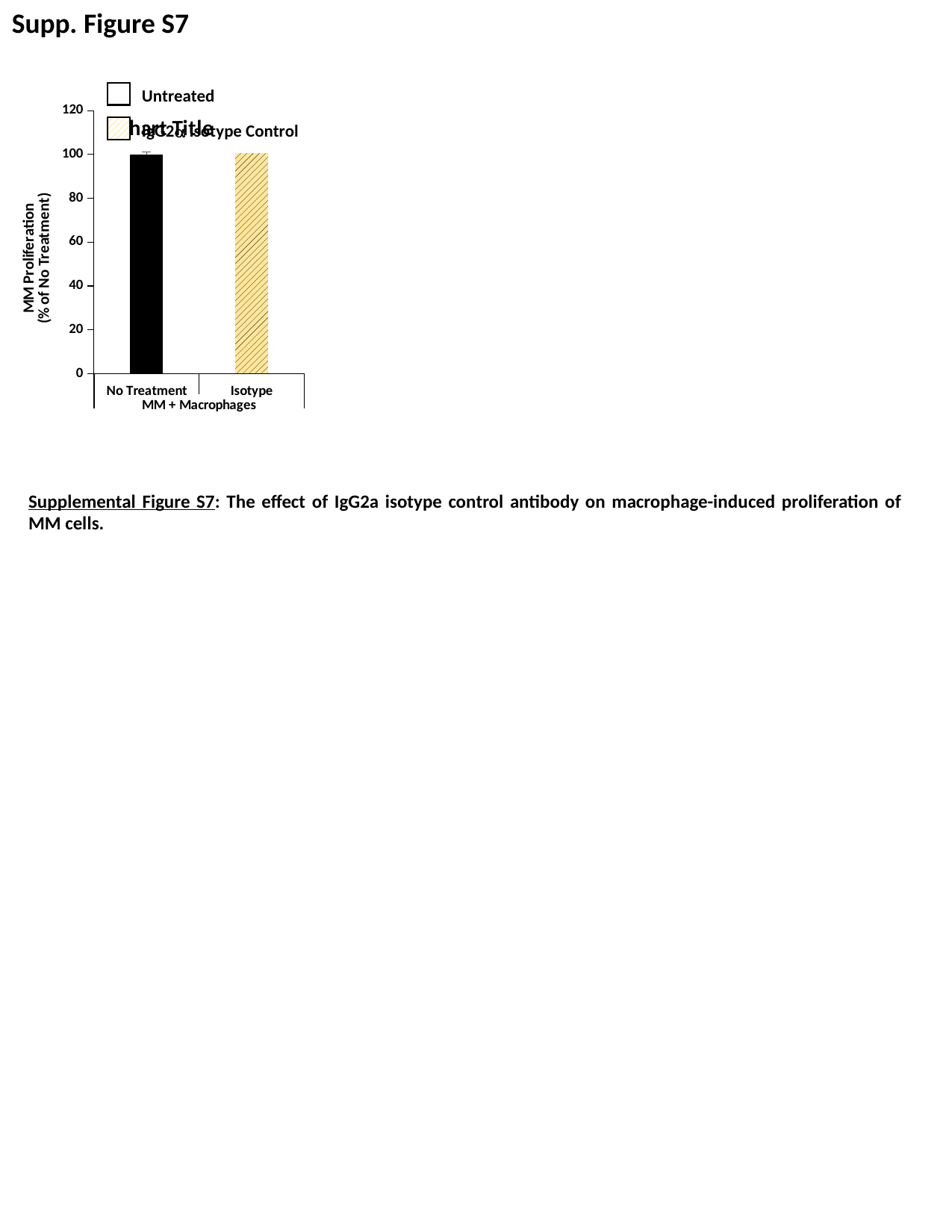
Is the value for Isotype greater or less than 120? less How many series does the chart legend list? 2 Is the value for Isotype greater or less than 60? greater Is the value for Isotype greater or less than 80? greater What group label appears beneath the two category labels on the x axis? MM + Macrophages What kind of chart is shown on the slide? bar chart How many bars (categories) are plotted in the chart? 2 What is the label of the y axis of the chart? MM Proliferation (% of No Treatment)